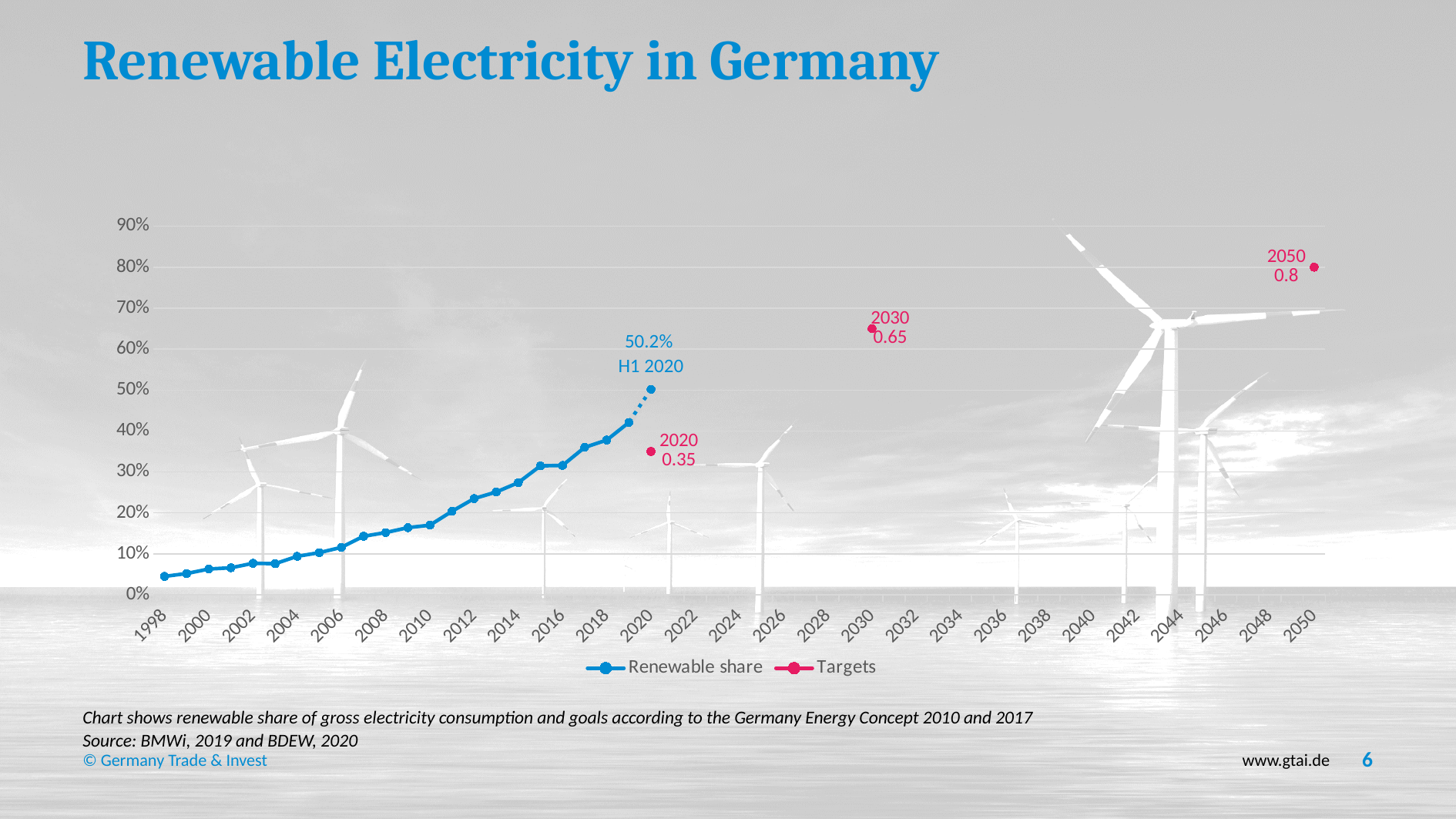
Does the renewable share rise or fall from 1998 to 2020? rise Which year has the highest target value? 2050 What is the target value shown for 2050? 0.8 How many series does the legend list? 2 How many target points are plotted on the chart? 3 What renewable share is labelled for H1 2020? 50.2% What kind of chart is shown on the slide? line chart What is the target value shown for 2030? 0.65 What is the difference between the 2050 target and the 2030 target? 0.15 Is the renewable share for 2014 greater or less than 30%? less What is the target value shown for 2020? 0.35 Is the renewable share for 1998 greater or less than 10%? less